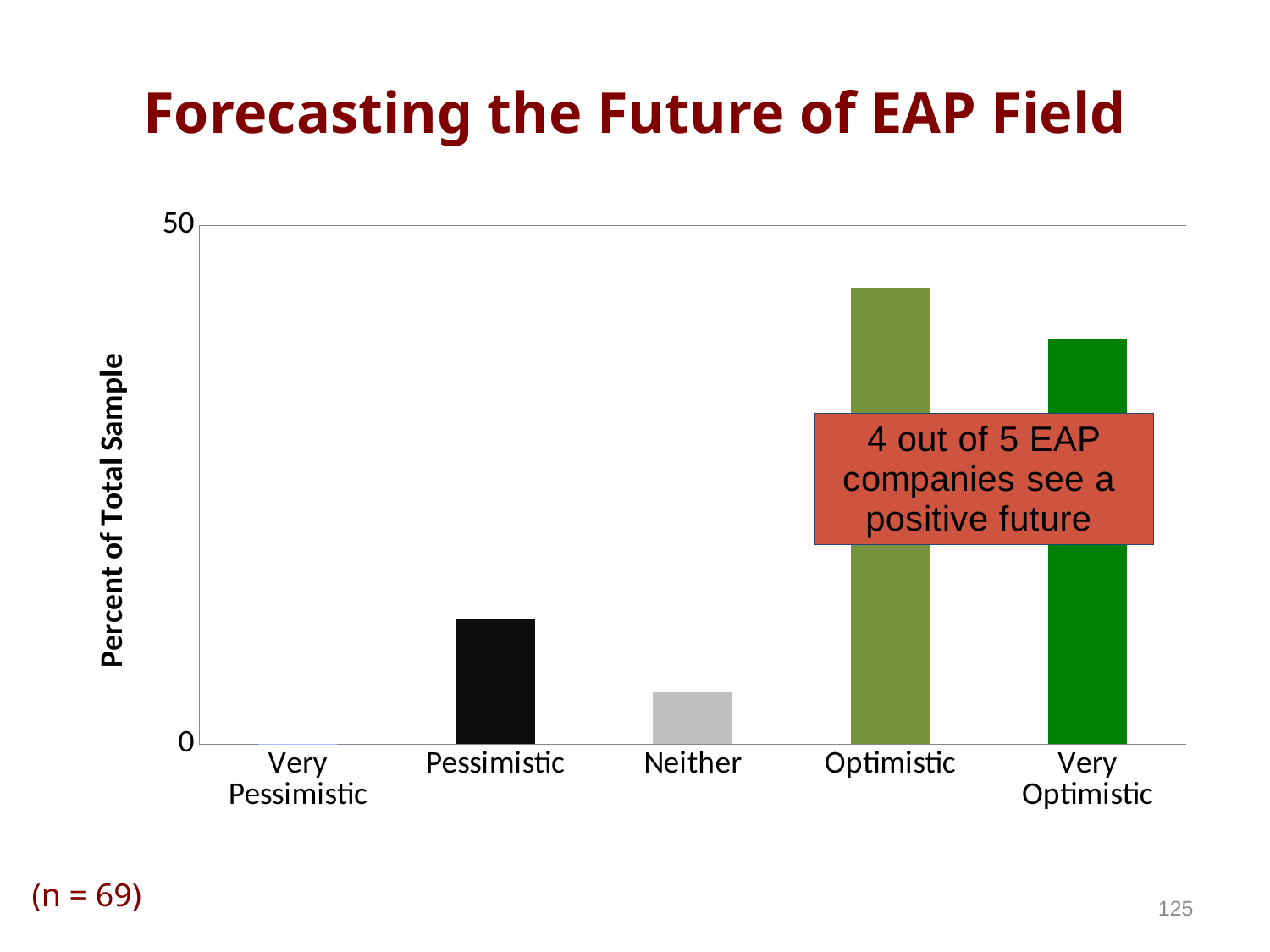
Is the value for Optimistic greater or less than 50? less What kind of chart is shown on the slide? bar chart Which category has the highest bar in the chart? Optimistic Which is larger, the value for Optimistic or the value for Very Optimistic? Optimistic What is the label on the y axis of the chart? Percent of Total Sample Which category has the lowest value in the chart? Very Pessimistic How many categories are shown on the x axis of the chart? 5 Which is larger, the value for Very Optimistic or the value for Pessimistic? Very Optimistic What is the title of the chart on the slide? Forecasting the Future of EAP Field Is the value for Very Optimistic greater or less than 50? less Which is larger, the value for Pessimistic or the value for Neither? Pessimistic